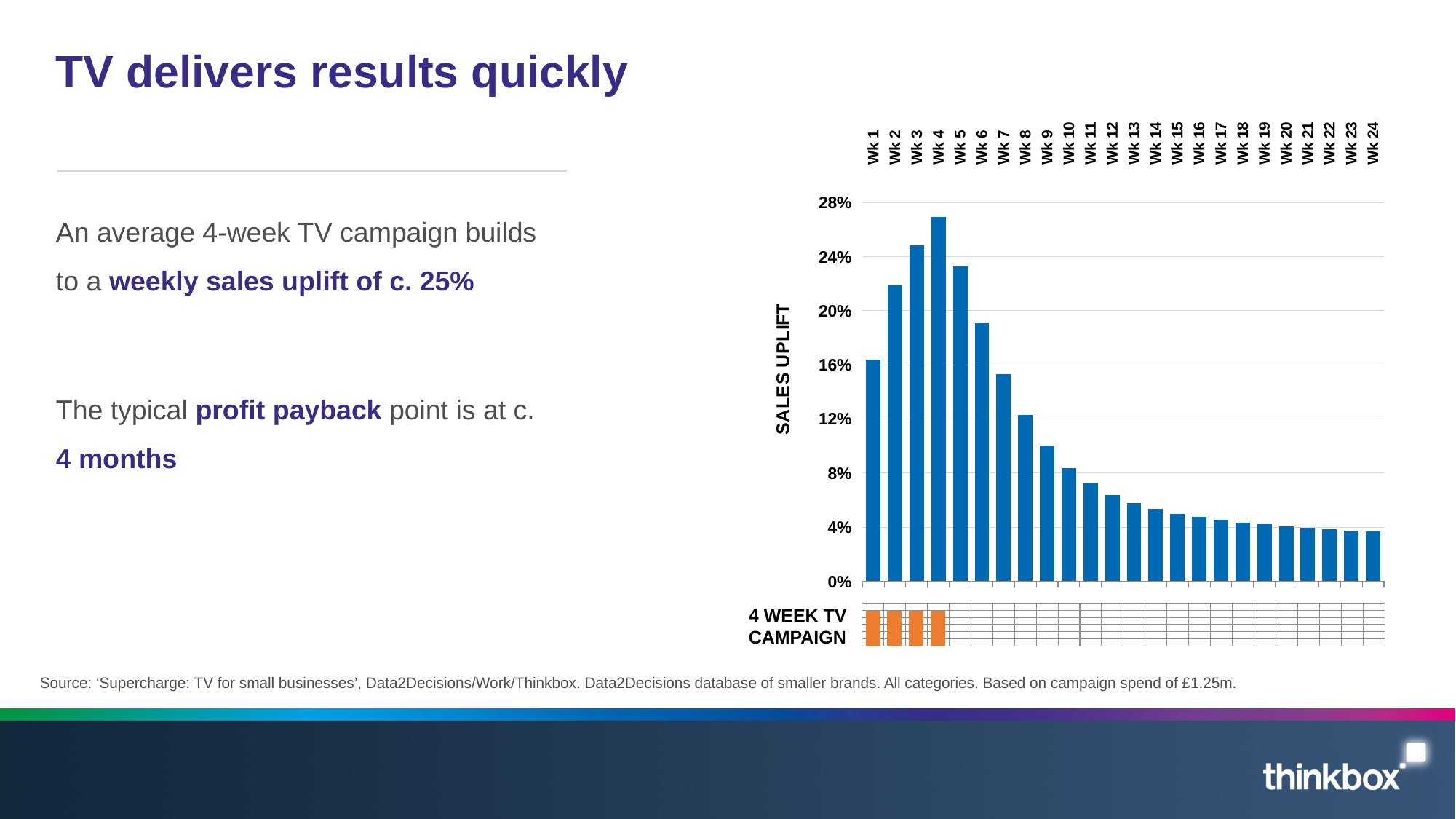
What is the label on the vertical axis of the chart? SALES UPLIFT Is the sales uplift for Wk 9 greater or less than 12%? less Which week has the highest sales uplift? Wk 4 Is the sales uplift for Wk 4 greater or less than 24%? greater How many weeks are plotted on the x axis of the chart? 24 After Wk 4, do the sales uplift values rise or fall across the remaining weeks? fall What kind of chart is shown on the slide? bar chart Which has the larger sales uplift, Wk 10 or Wk 20? Wk 10 Is the sales uplift for Wk 2 greater or less than 20%? greater Which has the larger sales uplift, Wk 3 or Wk 5? Wk 3